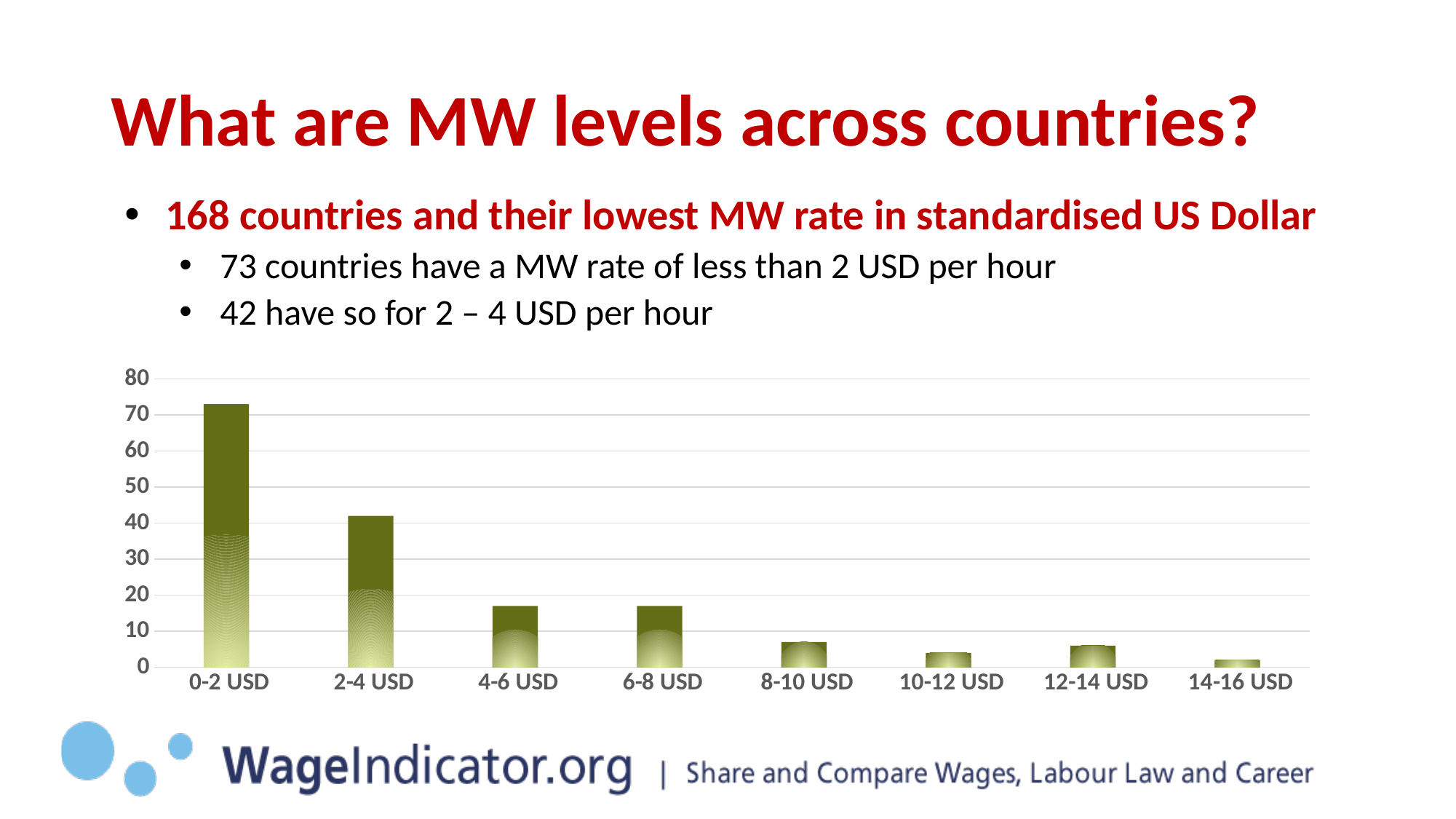
Is the value for 6-8 USD greater or less than 10? greater Which has more countries, the 2-4 USD range or the 4-6 USD range? 2-4 USD Is the value for 4-6 USD greater or less than 20? less What type of chart is shown on the slide? bar chart How many countries have a lowest MW rate in the 0-2 USD range? 73 Which USD range has the highest number of countries in the chart? 0-2 USD Is the value for 10-12 USD greater or less than 10? less Do the values generally rise or fall moving from left to right along the x axis? fall How many countries have a lowest MW rate in the 2-4 USD range? 42 Which USD range has the lowest number of countries in the chart? 14-16 USD How many USD ranges (categories) are shown on the x axis of the chart? 8 How many more countries are in the 0-2 USD range than in the 2-4 USD range? 31